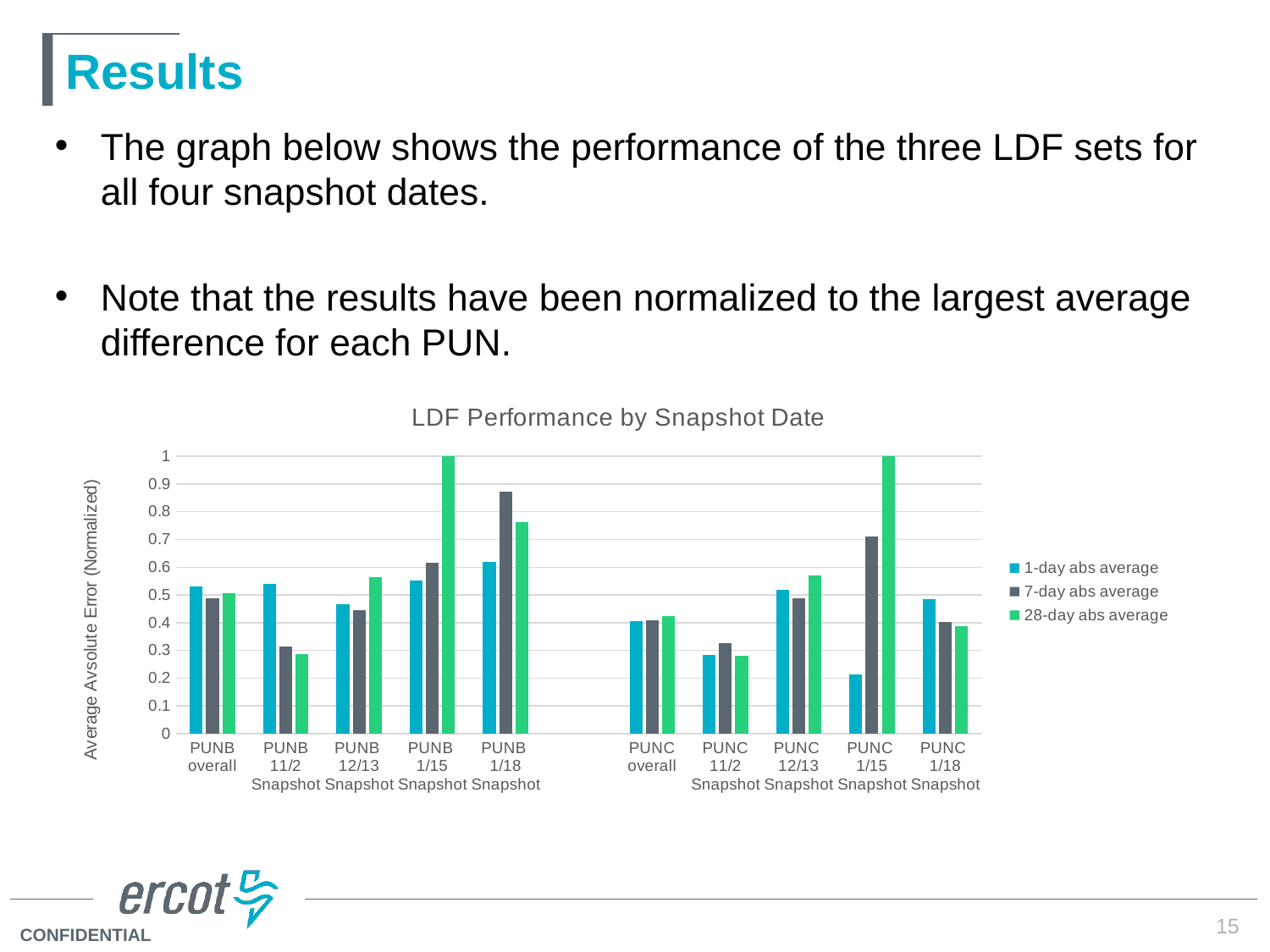
What is the 28-day abs average value for PUNC 1/15 Snapshot? 1 What is the title of the chart? LDF Performance by Snapshot Date For PUNB 11/2 Snapshot, which is larger: the 1-day abs average or the 7-day abs average? 1-day abs average What is the 28-day abs average value for PUNB 1/15 Snapshot? 1 Is the 1-day abs average value for PUNC 1/15 Snapshot greater or less than 0.3? less Which series has the highest value for PUNB 1/15 Snapshot? 28-day abs average Which category has the lowest 1-day abs average value? PUNC 1/15 Snapshot How many series does the legend list? 3 How many categories are shown along the x axis? 10 Is the 7-day abs average value for PUNB 1/18 Snapshot greater or less than 0.8? greater What type of chart is shown on the slide? Bar chart Which category has the highest 7-day abs average value? PUNB 1/18 Snapshot